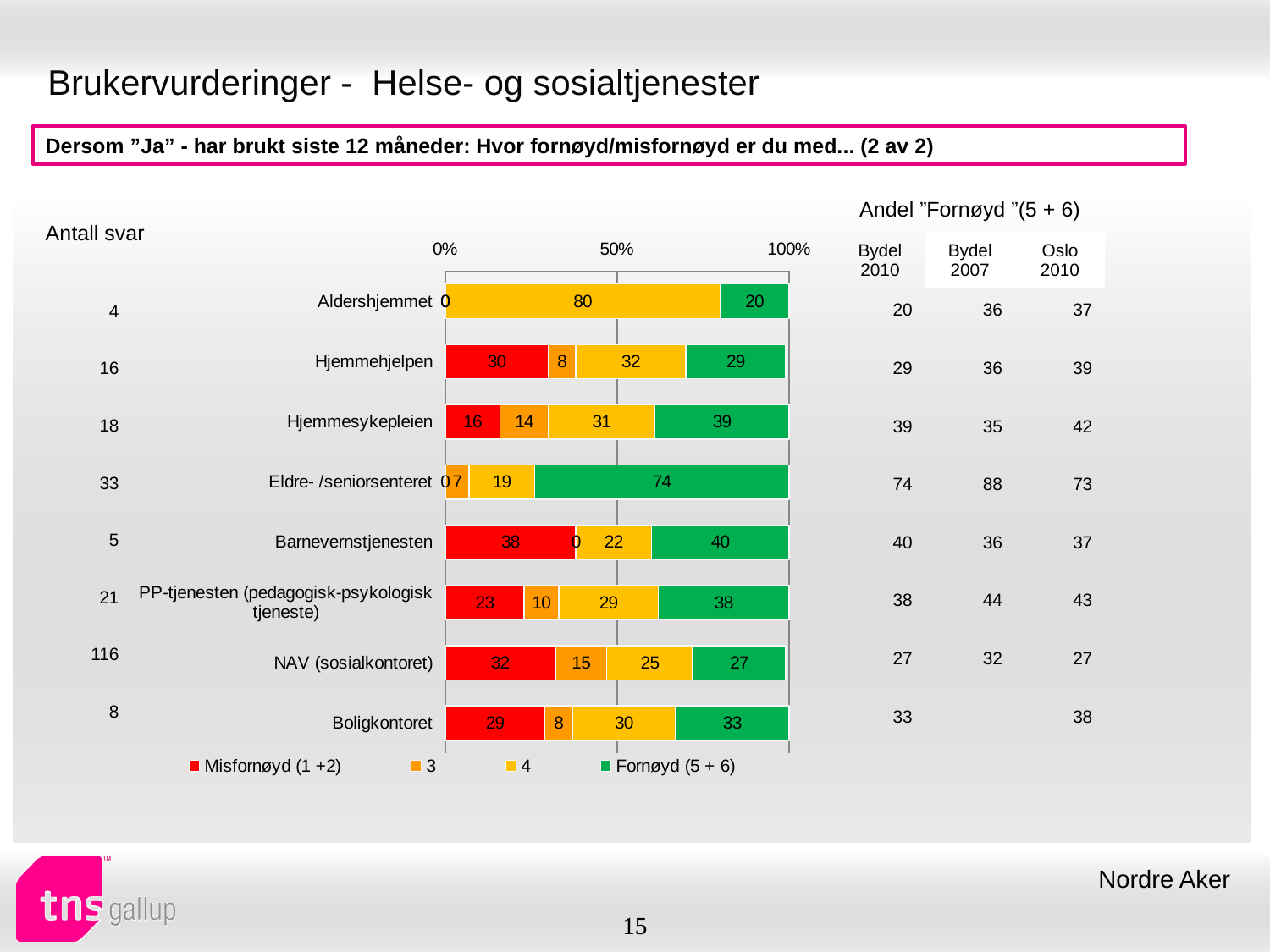
What is the difference between the Misfornøyd (1 +2) and Fornøyd (5 + 6) values for NAV (sosialkontoret)? 5 What kind of chart is shown on the slide? Stacked bar chart How many categories are shown in the chart? 8 What is the value of the '3' segment for Hjemmesykepleien? 14 Which category has the lowest Fornøyd (5 + 6) value? Aldershjemmet What is the value of the Misfornøyd (1 +2) segment for NAV (sosialkontoret)? 32 Which has a larger Fornøyd (5 + 6) value, Hjemmesykepleien or Hjemmehjelpen? Hjemmesykepleien How many series does the legend list? 4 What is the value of the '4' segment for Boligkontoret? 30 Which category has the highest Fornøyd (5 + 6) value? Eldre- /seniorsenteret Which category has the highest Misfornøyd (1 +2) value? Barnevernstjenesten What is the value of the Fornøyd (5 + 6) segment for Eldre- /seniorsenteret? 74